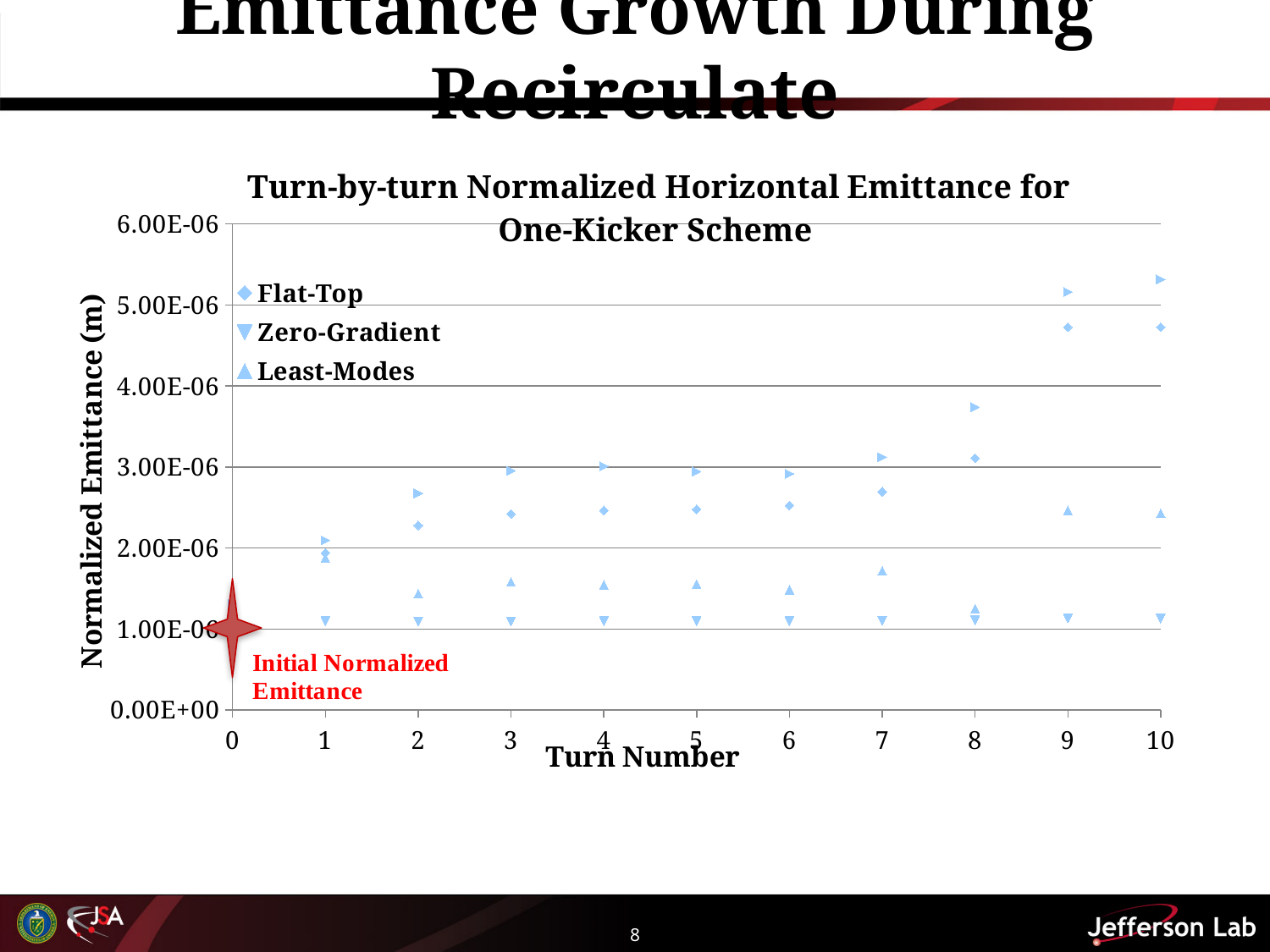
How many turn numbers have data points plotted? 10 Do the Flat-Top values generally rise or fall as the turn number increases? rise At turn 9, which is larger, the Flat-Top value or the Zero-Gradient value? Flat-Top Is the Least-Modes value at turn 9 greater or less than 2.00E-06? greater Is the Flat-Top value at turn 7 greater or less than 3.00E-06? less What kind of chart is shown on the slide? scatter chart Is the Zero-Gradient value at turn 5 greater or less than 2.00E-06? less What is the label of the y axis? Normalized Emittance (m) What is the title of the chart? Turn-by-turn Normalized Horizontal Emittance for One-Kicker Scheme How many series does the chart legend list? 3 Of the series listed in the legend, which has the lowest value at turn 10? Zero-Gradient